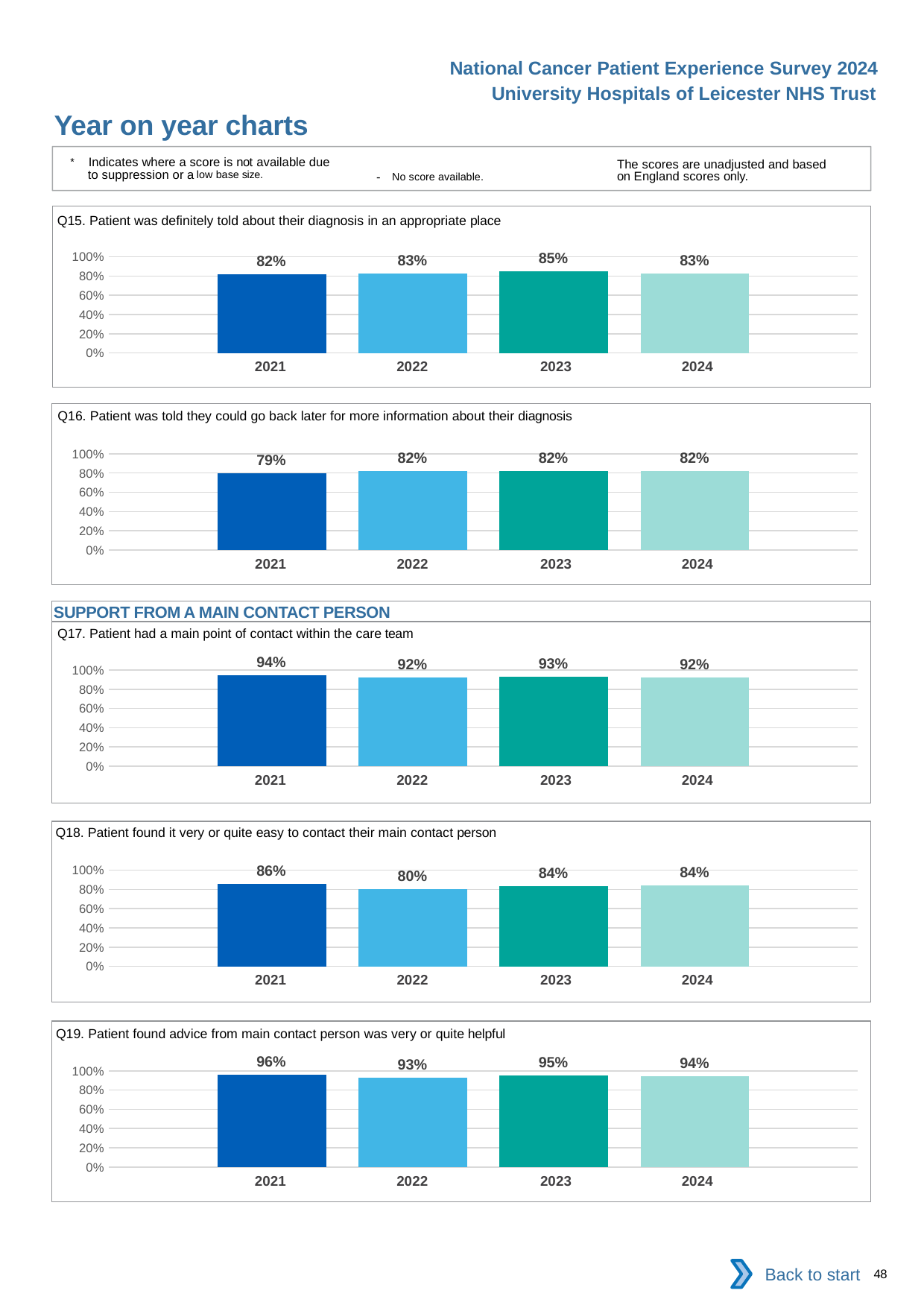
What is the section heading printed above the Q17 chart? SUPPORT FROM A MAIN CONTACT PERSON In the Q15 chart (patient was definitely told about their diagnosis in an appropriate place), what is the value for 2023? 85% What kind of chart is the Q19 chart? bar chart In the Q16 chart, what is the value for 2024? 82% In the Q18 chart (patient found it very or quite easy to contact their main contact person), which year has the lowest value? 2022 In the Q16 chart, is the value for 2021 greater or less than 60%? greater How many years are shown on the x axis of the Q17 chart? 4 In the Q17 chart (patient had a main point of contact within the care team), which year has the highest value? 2021 In the Q19 chart (patient found advice from main contact person was very or quite helpful), what is the difference between the 2021 and 2022 values? 3% In the Q16 chart (patient was told they could go back later for more information about their diagnosis), what is the value for 2021? 79% In the Q15 chart, which is larger, the value for 2021 or the value for 2023? 2023 In the Q18 chart, what is the difference between the 2021 and 2022 values? 6%